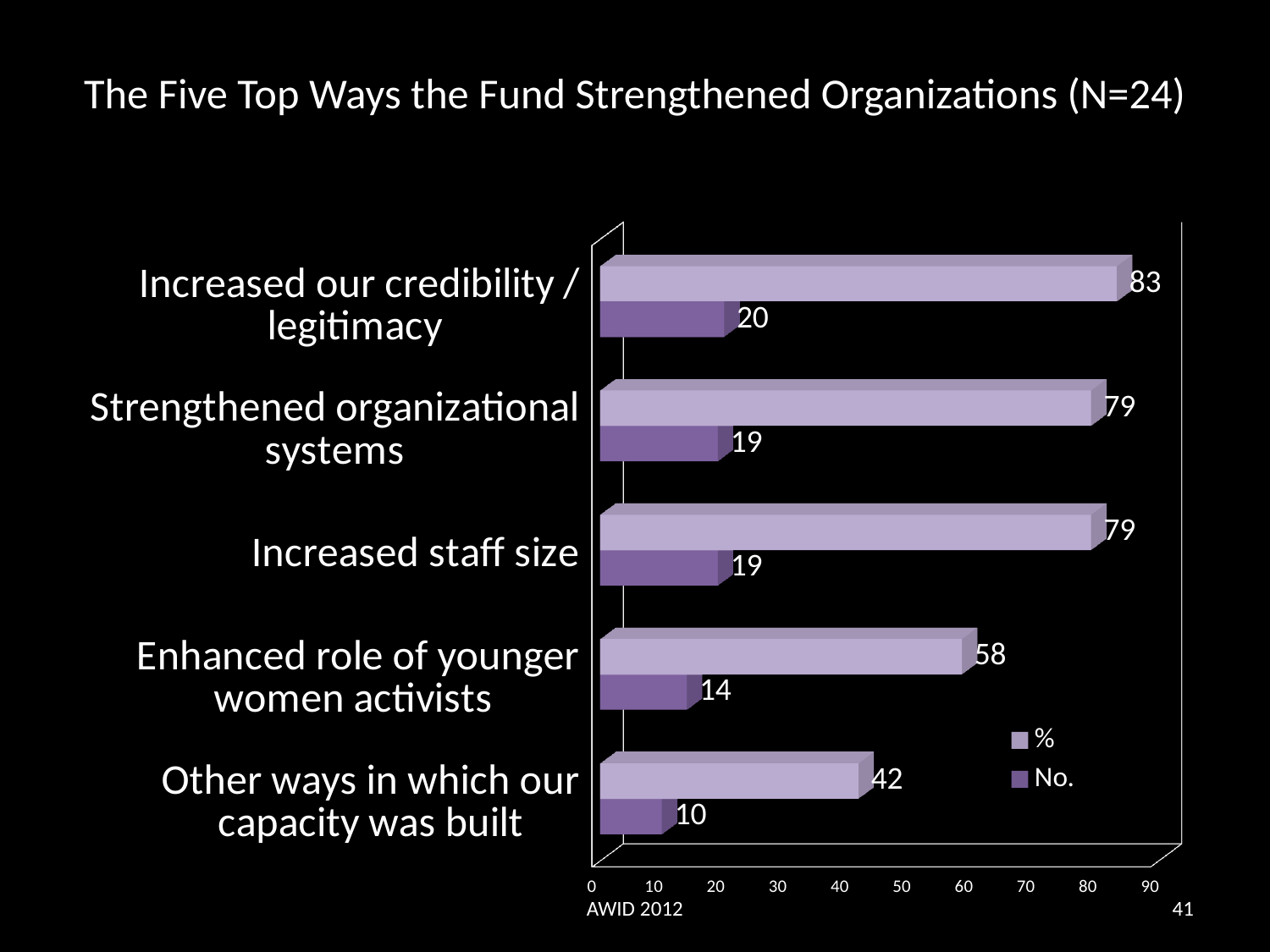
Which category has the lowest No. value? Other ways in which our capacity was built What is the No. value for 'Enhanced role of younger women activists'? 14 What is the difference between the % values for 'Increased our credibility / legitimacy' and 'Enhanced role of younger women activists'? 25 What is the % value for 'Increased our credibility / legitimacy'? 83 What is the % value for 'Other ways in which our capacity was built'? 42 What is the title of the chart? The Five Top Ways the Fund Strengthened Organizations (N=24) How many categories are shown in the chart? 5 What is the No. value for 'Increased staff size'? 19 Which is larger: the No. value for 'Increased our credibility / legitimacy' or the No. value for 'Enhanced role of younger women activists'? Increased our credibility / legitimacy How many series does the legend list? 2 What kind of chart is shown on the slide? Bar chart Which category has the highest % value? Increased our credibility / legitimacy